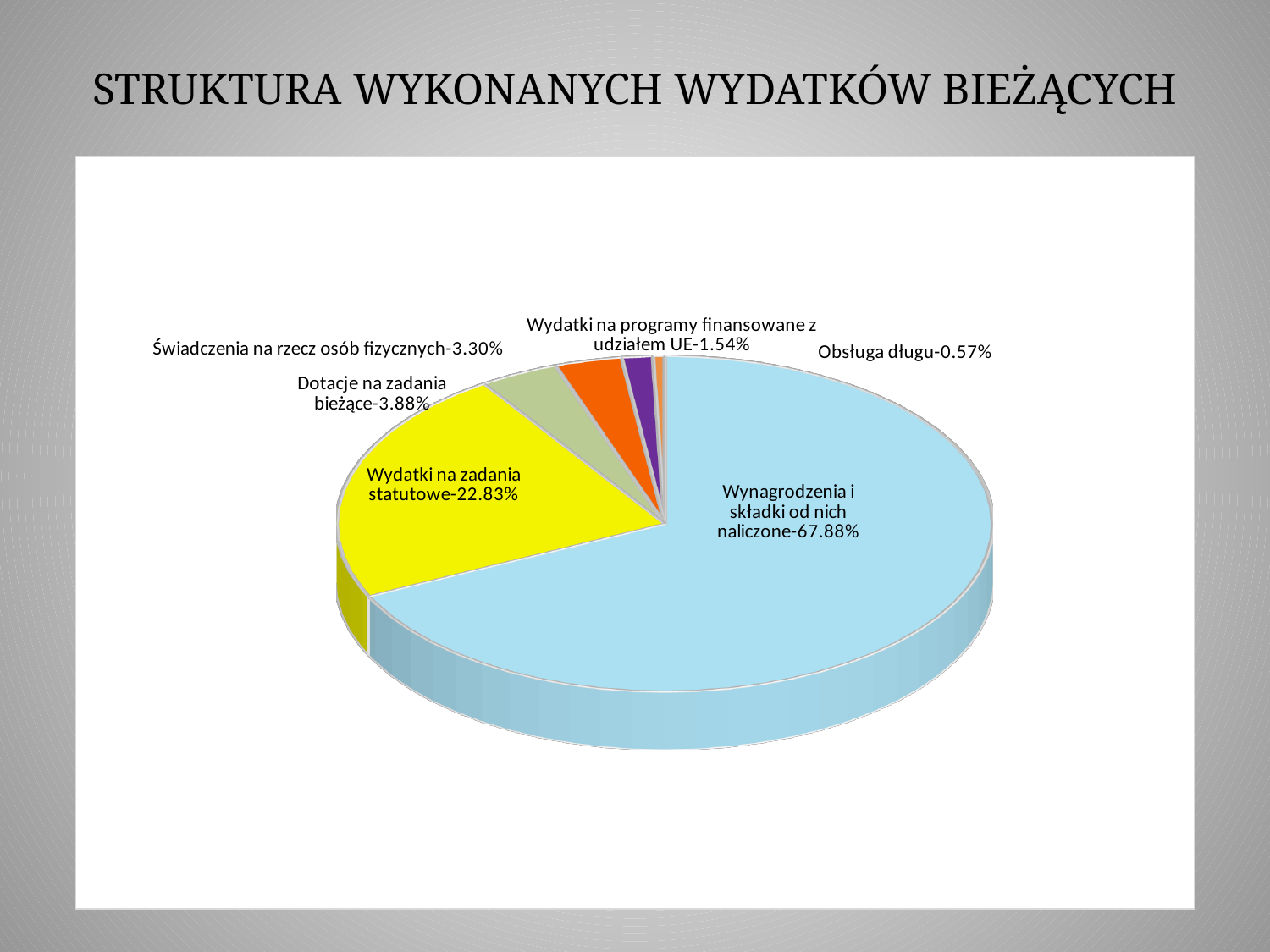
What is the title of the chart on the slide? STRUKTURA WYKONANYCH WYDATKÓW BIEŻĄCYCH How many slices does the pie chart have? 6 What share of the pie is 'Wydatki na programy finansowane z udziałem UE'? 1.54% Which category has the largest share of the pie? Wynagrodzenia i składki od nich naliczone What kind of chart is shown on the slide? pie chart What share of the pie is 'Świadczenia na rzecz osób fizycznych'? 3.30% What share of the pie is 'Obsługa długu'? 0.57% Which category has the smallest share of the pie? Obsługa długu What is the difference in percentage points between 'Wynagrodzenia i składki od nich naliczone' and 'Wydatki na zadania statutowe'? 45.05 What share of the pie is 'Wydatki na zadania statutowe'? 22.83% What share of the pie is 'Wynagrodzenia i składki od nich naliczone'? 67.88% What share of the pie is 'Dotacje na zadania bieżące'? 3.88%